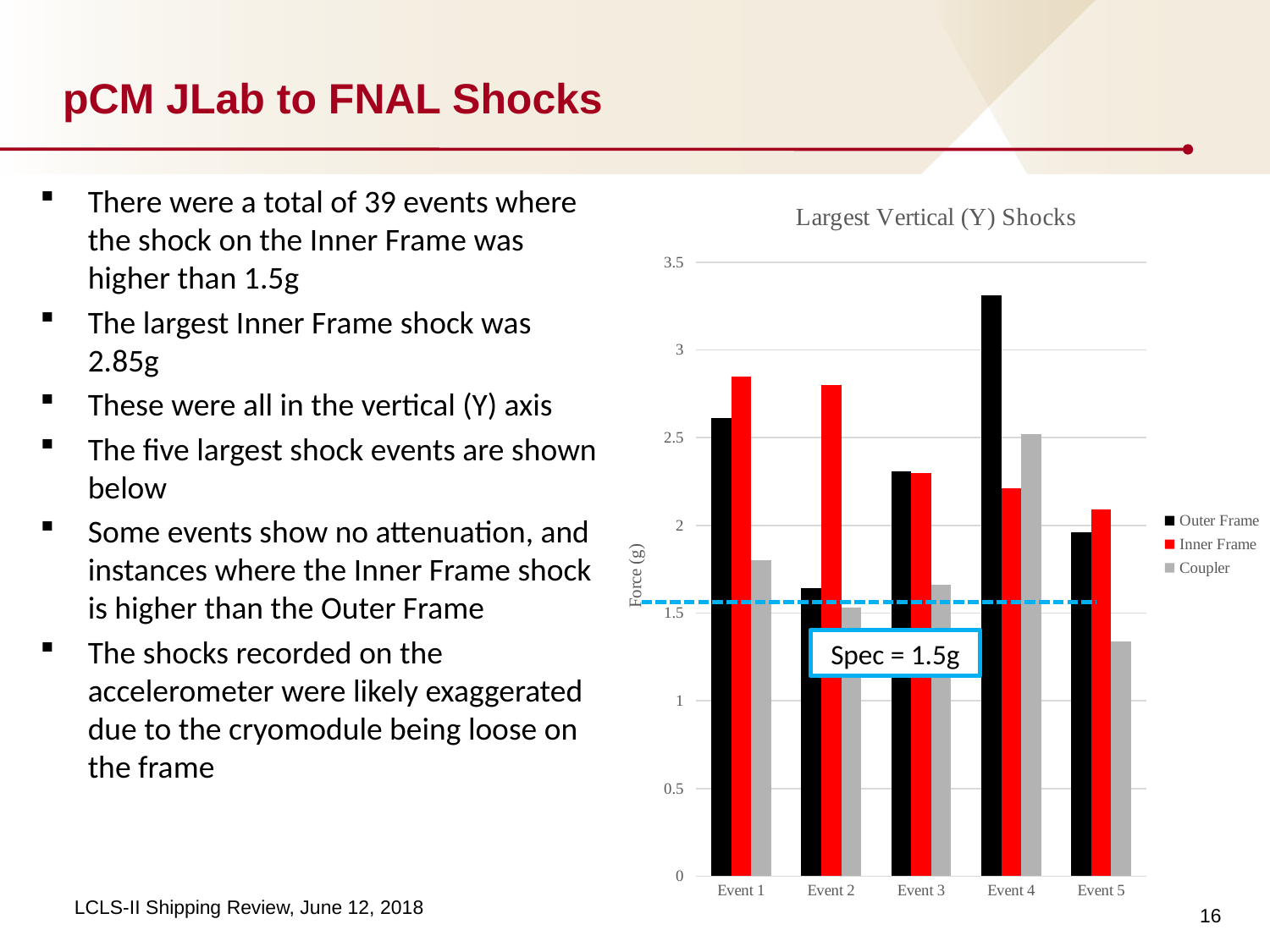
For Event 2, which is larger: the Outer Frame shock or the Inner Frame shock? Inner Frame What value does the dashed horizontal line on the chart represent? Spec = 1.5g For which event is the Outer Frame shock the lowest? Event 2 Is the Outer Frame value for Event 4 greater or less than 3? greater For which event is the Coupler shock the lowest? Event 5 How many events are shown on the x axis of the chart? 5 For which event is the Outer Frame shock the highest? Event 4 What is the title of the chart? Largest Vertical (Y) Shocks Is the Coupler value for Event 5 greater or less than 1.5? less How many series does the chart legend list? 3 What type of chart is shown on the slide? bar chart Is the Inner Frame value for Event 2 greater or less than 2.5? greater